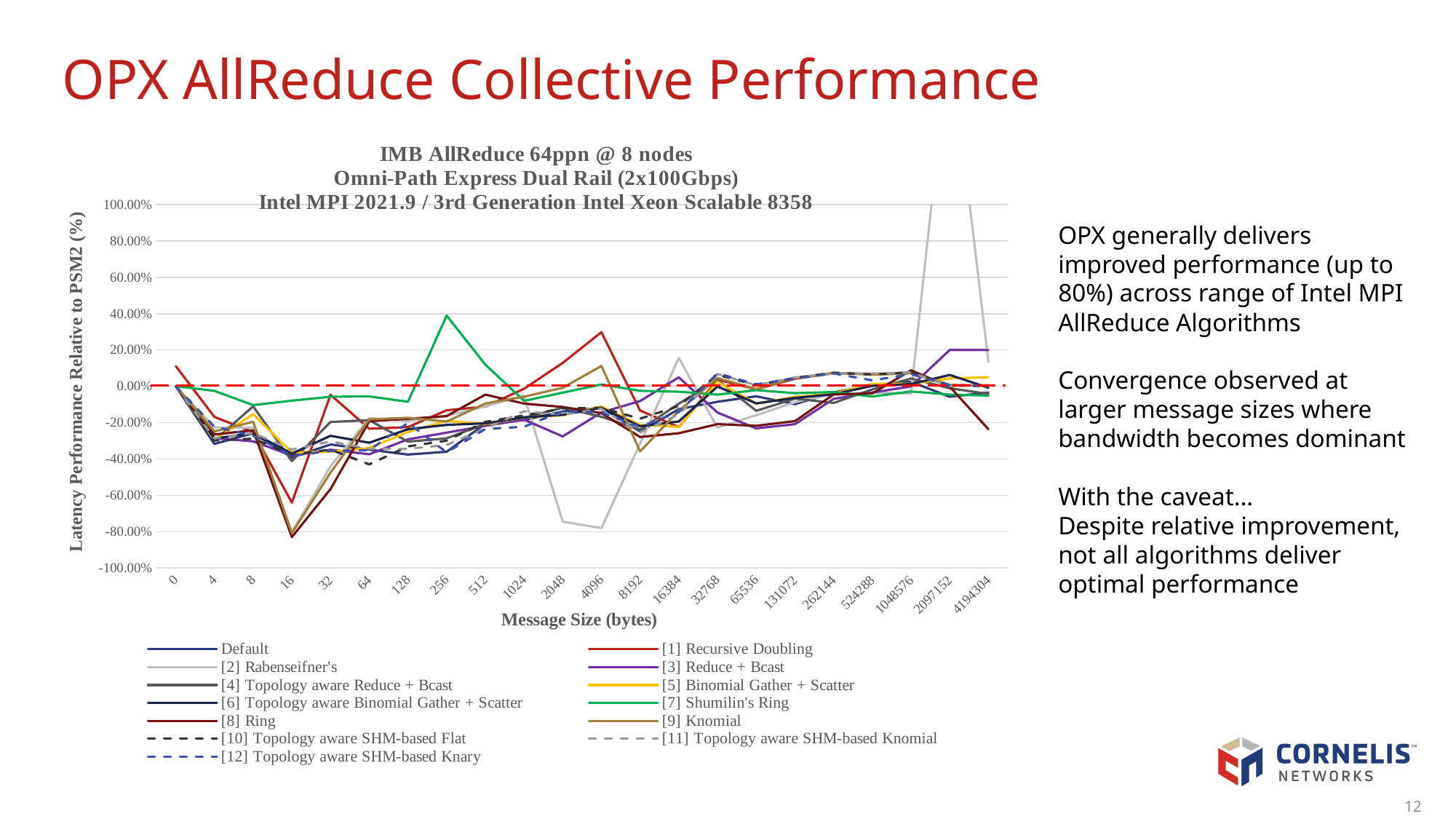
How many message sizes are plotted along the x axis? 22 Which series has the highest value at message size 256? [7] Shumilin's Ring What kind of chart is shown on the slide? Line chart Is the value for [1] Recursive Doubling at message size 4096 greater or less than 20.00%? greater Is the value for [2] Rabenseifner's at message size 2097152 greater or less than 80.00%? greater Which series has the lowest value at message size 2048? [2] Rabenseifner's What is the title of the chart's y axis? Latency Performance Relative to PSM2 (%) Does the value for [7] Shumilin's Ring rise or fall from message size 128 to 256? rises At message size 4096, which is larger: [1] Recursive Doubling or [2] Rabenseifner's? [1] Recursive Doubling Is the value for [7] Shumilin's Ring at message size 256 greater or less than 20.00%? greater How many series does the chart legend list? 13